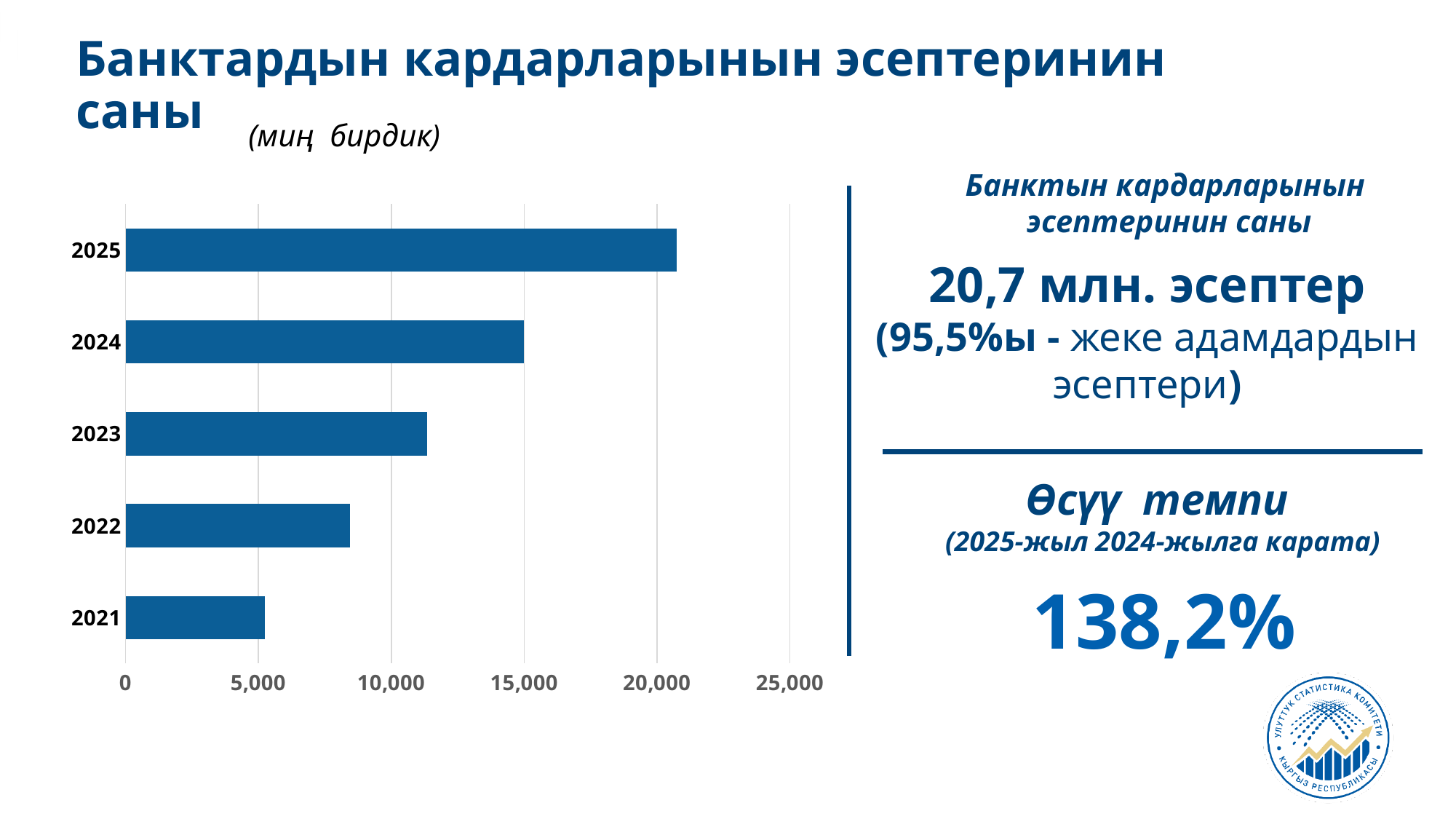
Which year has the highest value on the chart? 2025 Is the value for 2022 greater or less than 10,000? less How many years are shown on the chart? 5 Which year has the lowest value on the chart? 2021 What kind of chart is shown on the slide? bar chart Is the value for 2023 greater or less than 10,000? greater What is the highest value shown on the horizontal axis of the chart? 25,000 Which is larger, the value for 2023 or the value for 2022? 2023 Is the value for 2025 greater or less than 20,000? greater Do the values rise or fall from 2021 to 2025? rise What unit is given in parentheses under the chart title? миң бирдик